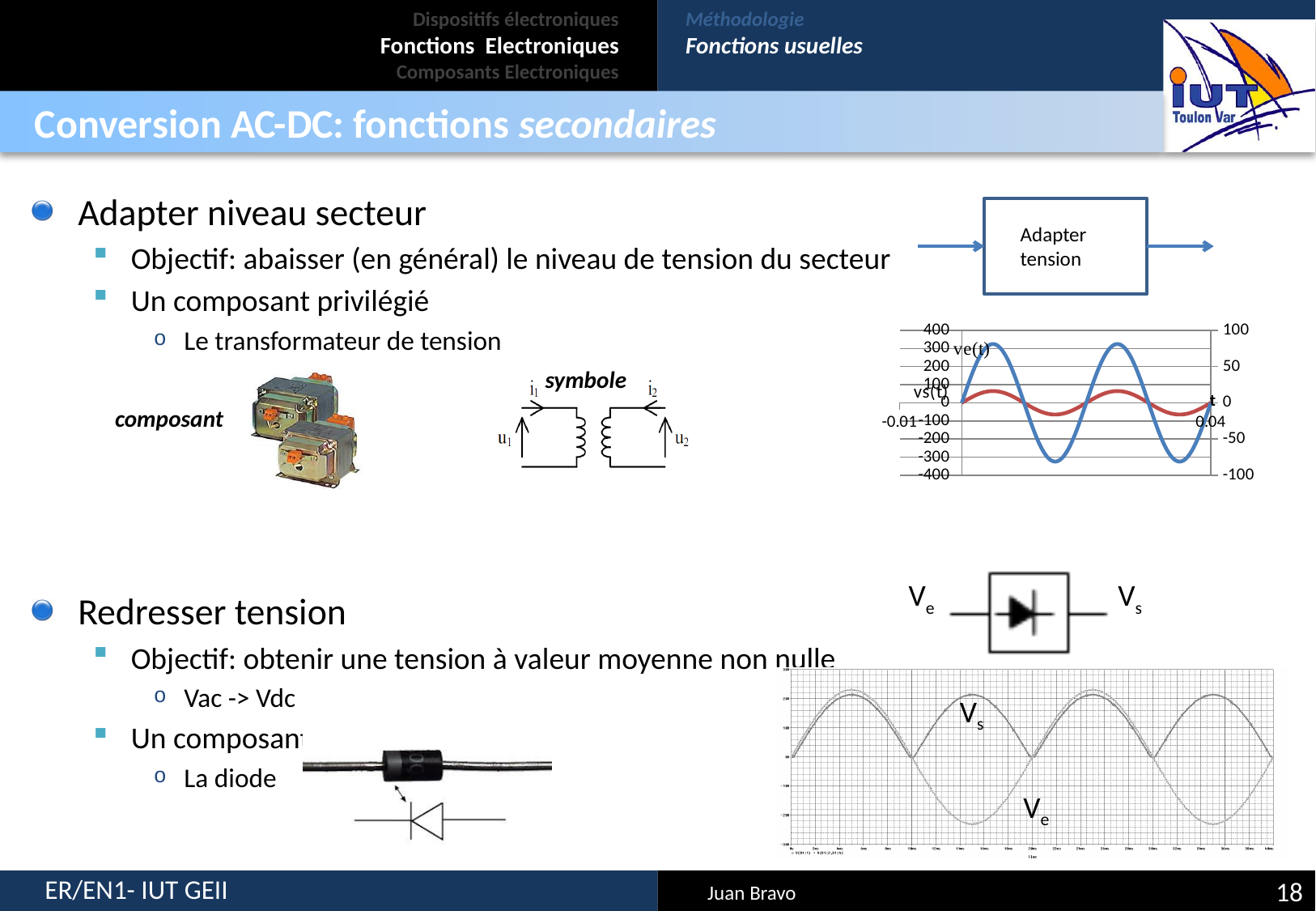
In the top-right chart, is the peak value of ve(t) on the left axis greater or less than 200? greater In the top-right chart, what colour is the ve(t) curve? blue In the top-right chart, how many positive peaks does the ve(t) curve show? 2 How many curves are plotted in the top-right chart showing ve(t) and vs(t)? 2 In the top-right chart, what is the highest tick value shown on the left vertical axis? 400 In the top-right chart, is the peak value of ve(t) on the left axis greater or less than 400? less In the top-right chart, does ve(t) rise or fall between t = 0 and its first peak? rise In the top-right chart, which curve has the larger amplitude, ve(t) or vs(t)? ve(t) What kind of chart is shown at the top right of the slide, next to the 'Adapter tension' block? line chart